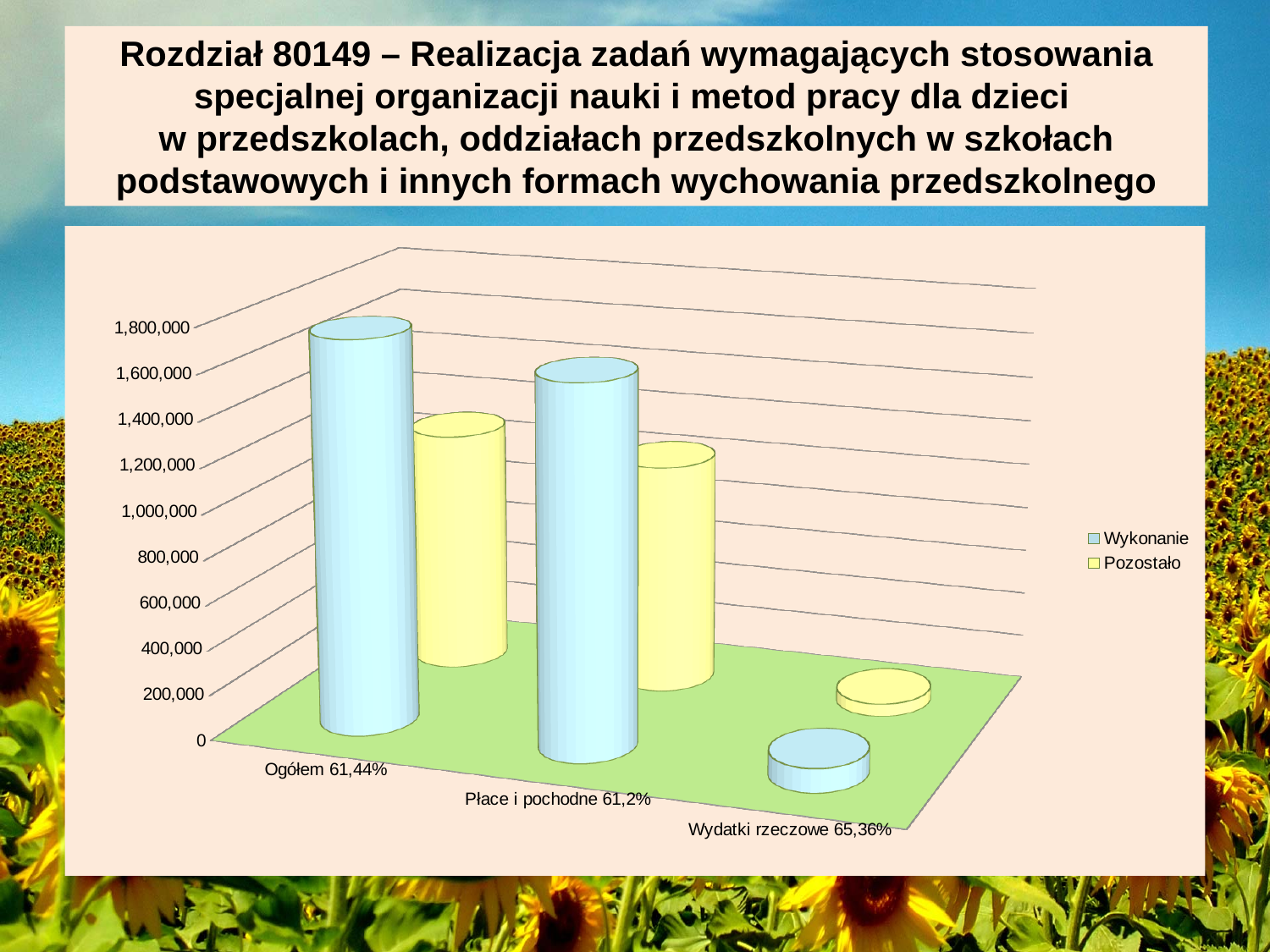
What are the two series named in the legend? Wykonanie and Pozostało Which category has the lowest Wykonanie value? Wydatki rzeczowe 65,36% Which category has the highest Pozostało value? Ogółem 61,44% How many series does the legend list? 2 Is the Pozostało value for Ogółem 61,44% greater or less than 600,000? greater Is the Wykonanie value for Wydatki rzeczowe 65,36% greater or less than 400,000? less Is the Wykonanie value for Ogółem 61,44% greater or less than 1,000,000? greater Which category has the lowest Pozostało value? Wydatki rzeczowe 65,36% For Płace i pochodne 61,2%, which is larger: Wykonanie or Pozostało? Wykonanie Which category has the highest Wykonanie value? Ogółem 61,44% What kind of chart is shown on the slide? bar chart How many categories are shown on the x axis? 3